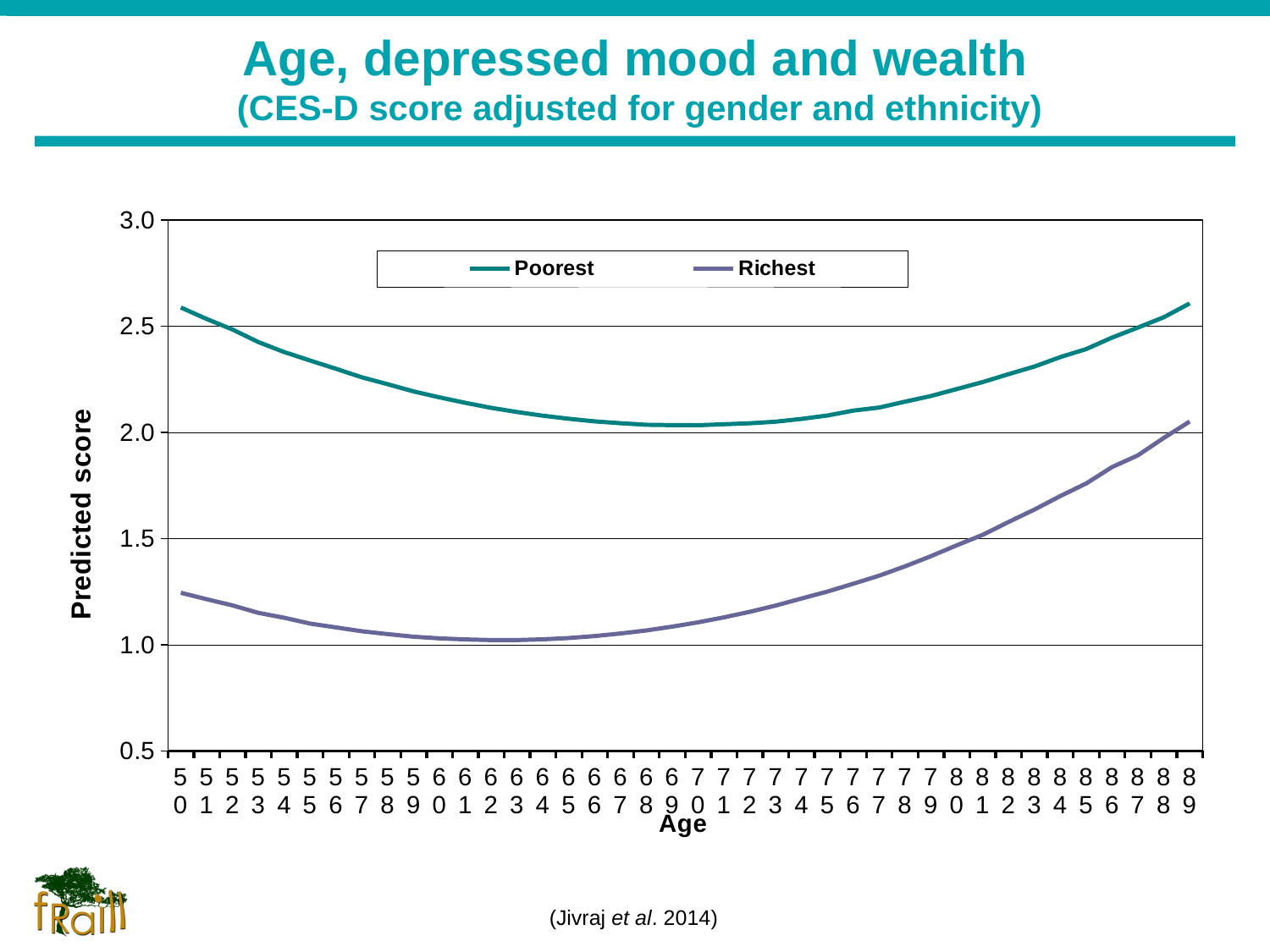
What kind of chart is shown on the slide? line chart How many series does the legend list? 2 What are the two series named in the legend? Poorest and Richest How many age points are shown along the x axis? 40 Is the value for Poorest at age 70 greater or less than 2.5? less Does the Richest line rise or fall between age 70 and age 89? rise What is the label of the y axis? Predicted score Is the value for Poorest at age 50 greater or less than 2.0? greater Is the value for Richest at age 89 greater or less than 1.5? greater At age 60, which series has the higher predicted score, Poorest or Richest? Poorest